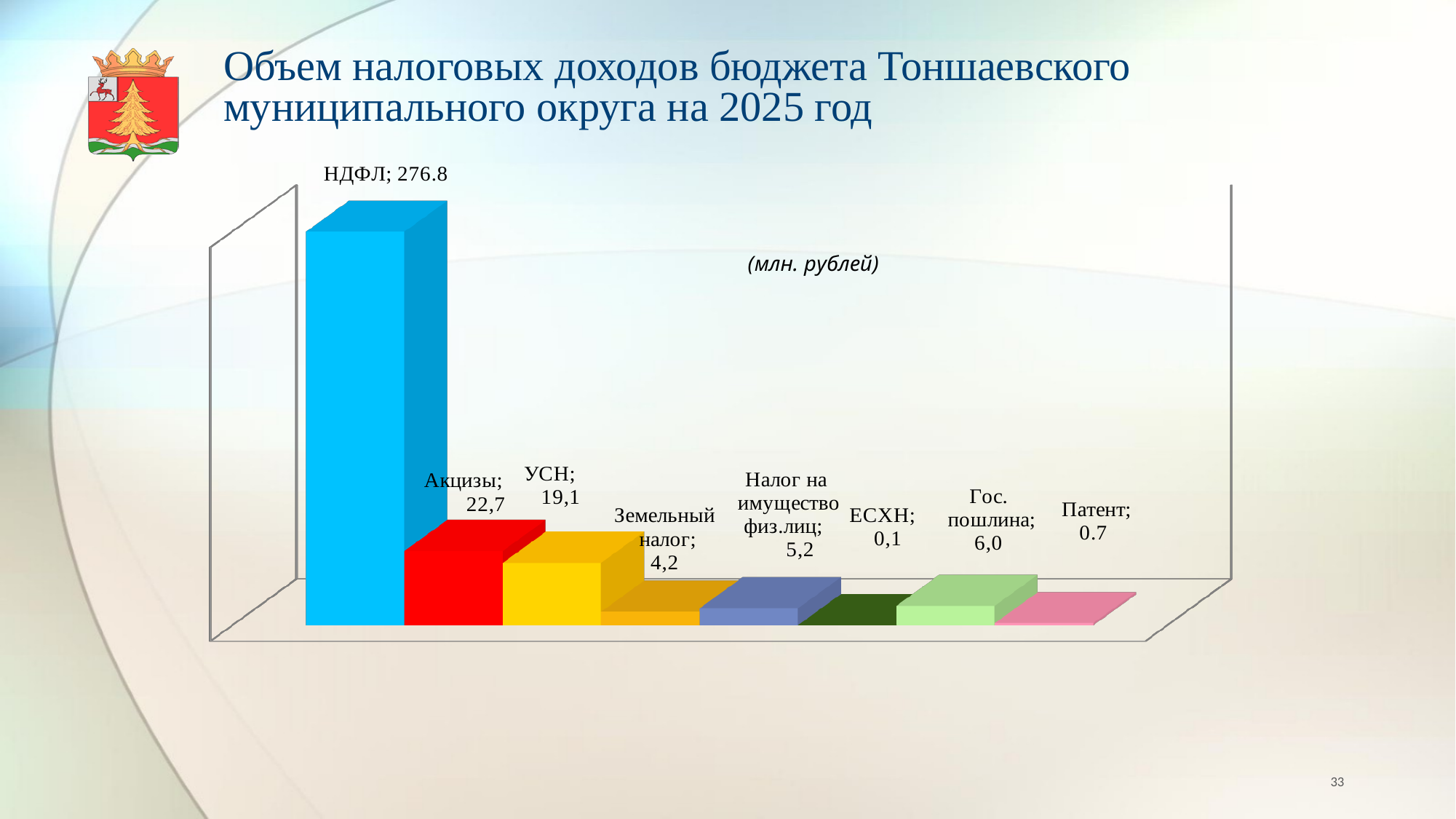
What is the value for Гос. пошлина? 6,0 Which is larger, the value for Земельный налог or the value for Патент? Земельный налог What unit is indicated for the values in the chart? млн. рублей What is the value for Акцизы? 22,7 What is the value for НДФЛ? 276.8 How many categories are shown in the chart? 8 What is the difference between the values for Гос. пошлина and Налог на имущество физ.лиц? 0,8 Which category has the highest value? НДФЛ What kind of chart is shown on the slide? bar chart What is the difference between the values for Акцизы and УСН? 3,6 Which category has the lowest value? ЕСХН What is the value for Налог на имущество физ.лиц? 5,2